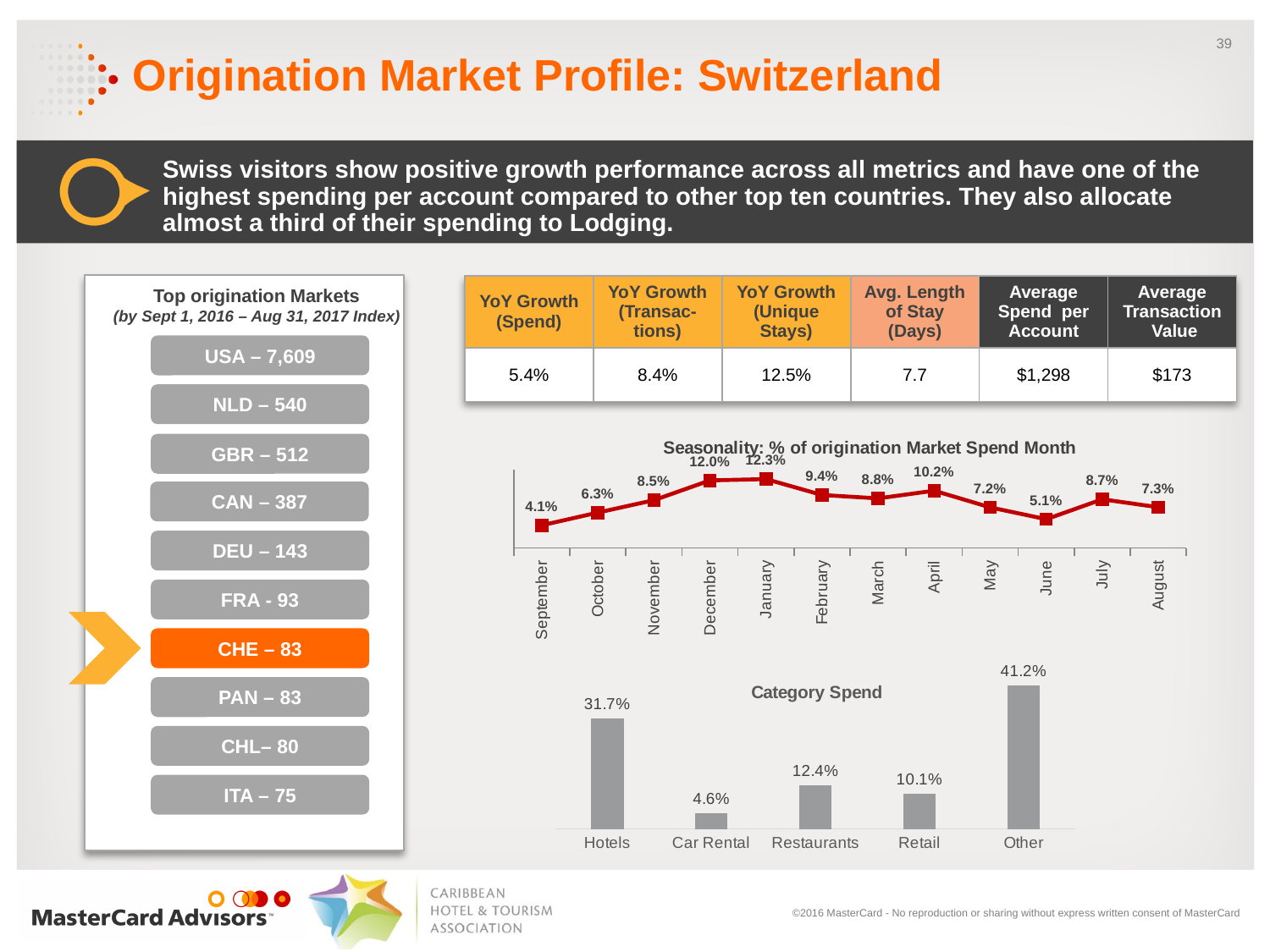
In the Category Spend chart, what is the value for Restaurants? 12.4% In the Seasonality chart, how many months are plotted? 12 What kind of chart is the Category Spend chart? Bar chart In the Seasonality chart, what is the difference between December and November? 3.5% In the Seasonality chart, which month has the lowest value? September In the Category Spend chart, which category has the lowest value? Car Rental What kind of chart is the Seasonality chart? Line chart In the Category Spend chart, which category has the highest value? Other In the Category Spend chart, which is larger, Hotels or Retail? Hotels In the Seasonality chart, what is the value for January? 12.3% In the Seasonality chart, which month has the highest value? January In the Seasonality chart, what is the value for September? 4.1%